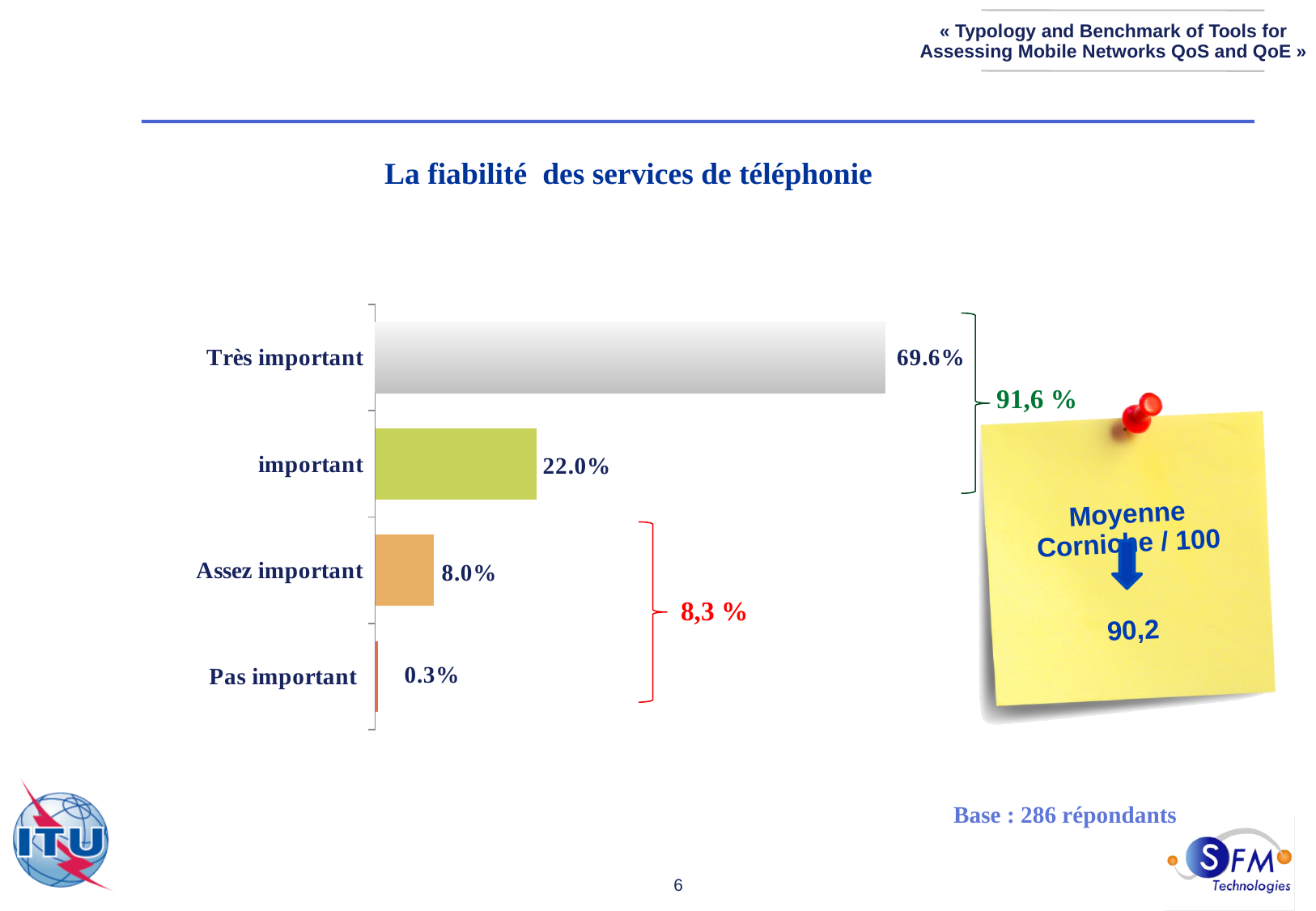
What is the difference between the values for "Très important" and "important"? 47.6% What is the value for "important"? 22.0% Which category has the lowest value? Pas important What is the value for "Pas important"? 0.3% What is the title of the chart? La fiabilité des services de téléphonie What is the value for "Très important"? 69.6% What combined percentage is shown by the bracket grouping "Très important" and "important"? 91,6 % Which category has the highest value? Très important How many categories are shown in the chart? 4 Which is larger, the value for "important" or the value for "Assez important"? important What kind of chart is shown on the slide? Bar chart What is the value for "Assez important"? 8.0%